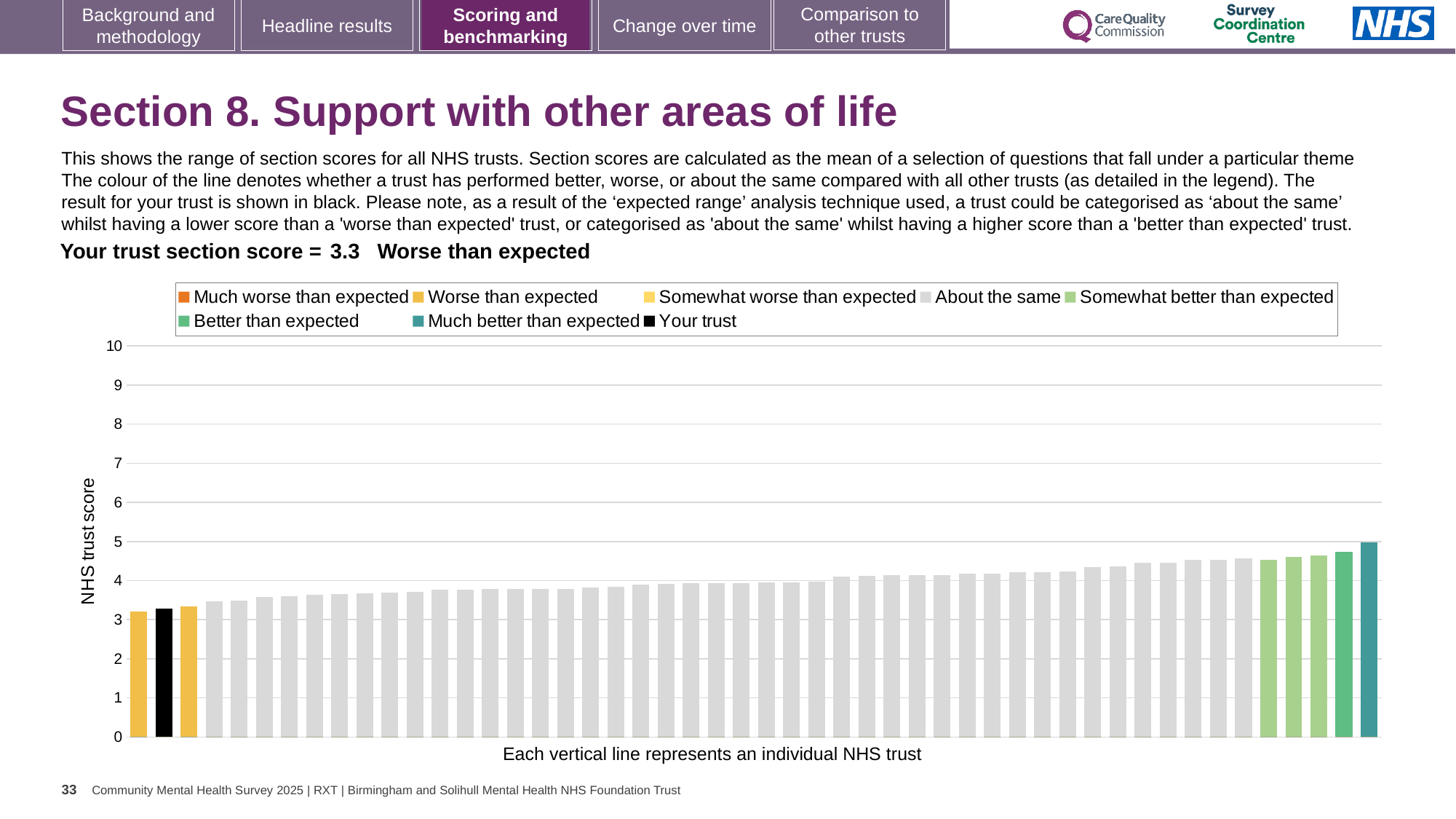
How many entries does the chart legend list? 8 Is your trust's section score greater or less than 3? greater How many bars are coloured as 'Much better than expected'? 1 Is the value of the tallest bar greater or less than 4? greater What is the label on the vertical axis of the chart? NHS trust score What kind of chart is shown on the slide? bar chart Which legend category does the tallest bar belong to? Much better than expected How many bars are coloured as 'Somewhat better than expected'? 3 Do the bar values rise or fall from left to right along the x axis? rise How is your trust's section score categorised? Worse than expected Is your trust's section score greater or less than 4? less What is the section score for your trust? 3.3